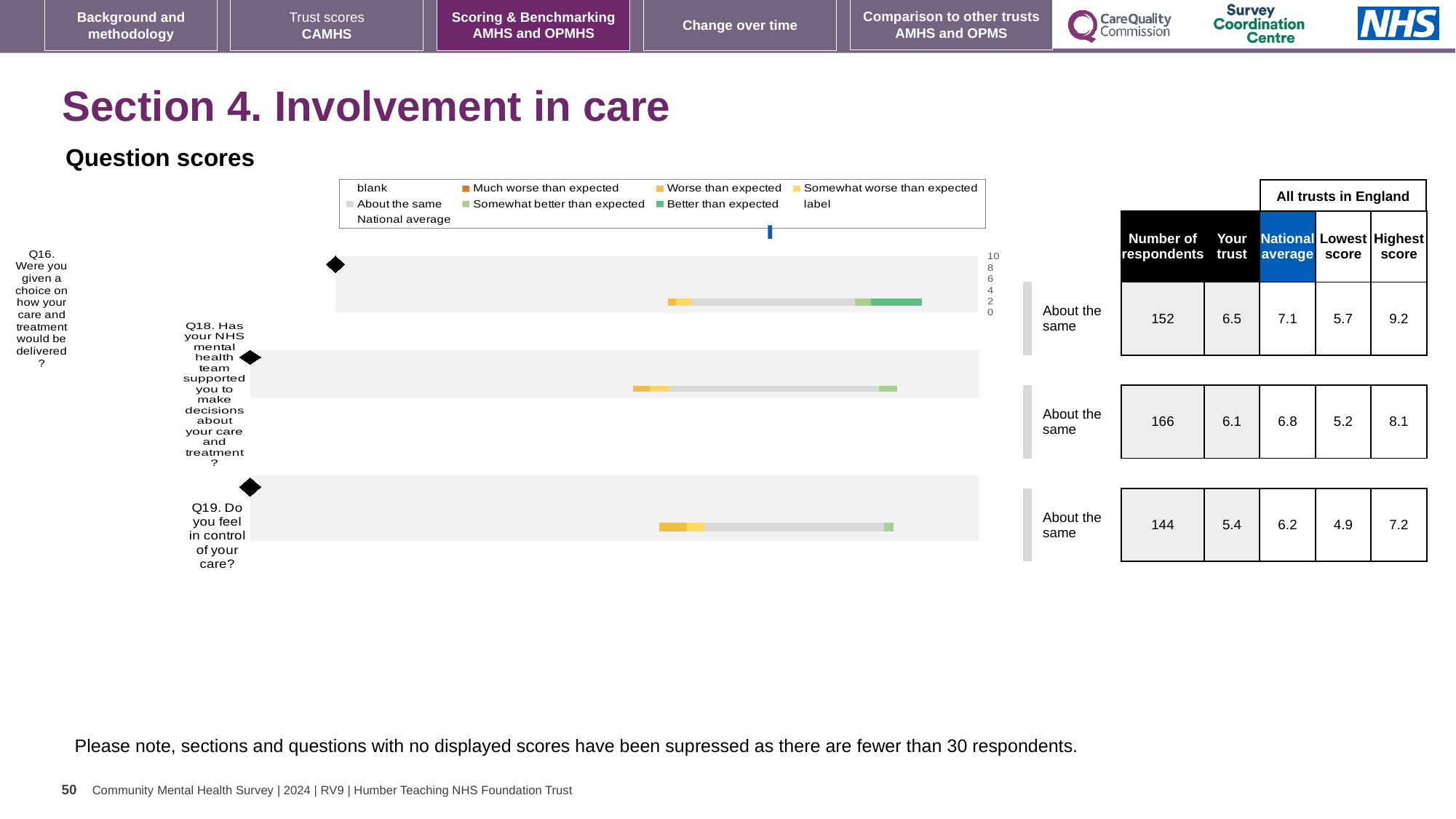
How many entries does the legend above the question scores charts list? 9 According to the table beside the Q19 chart, how many respondents answered Q19? 144 In the legend above the question scores charts, which entry is shown with an orange marker? Much worse than expected How many questions (categories) are plotted in the question scores charts? 3 Which question has the lowest 'Your trust' score in the table beside the charts? Q19 What is the difference between the national average and the 'Your trust' score for Q16? 0.6 Which is larger, the 'Your trust' score for Q16 or for Q18? Q16 Which question has the highest number of respondents in the table beside the charts? Q18 What is the difference between the highest score and the lowest score for Q19? 2.3 According to the table beside the Q18 chart, what is the national average for Q18? 6.8 What kind of chart is used to show the question scores for Q16, Q18 and Q19? bar chart According to the table beside the Q16 chart, what is the 'Your trust' score for Q16? 6.5